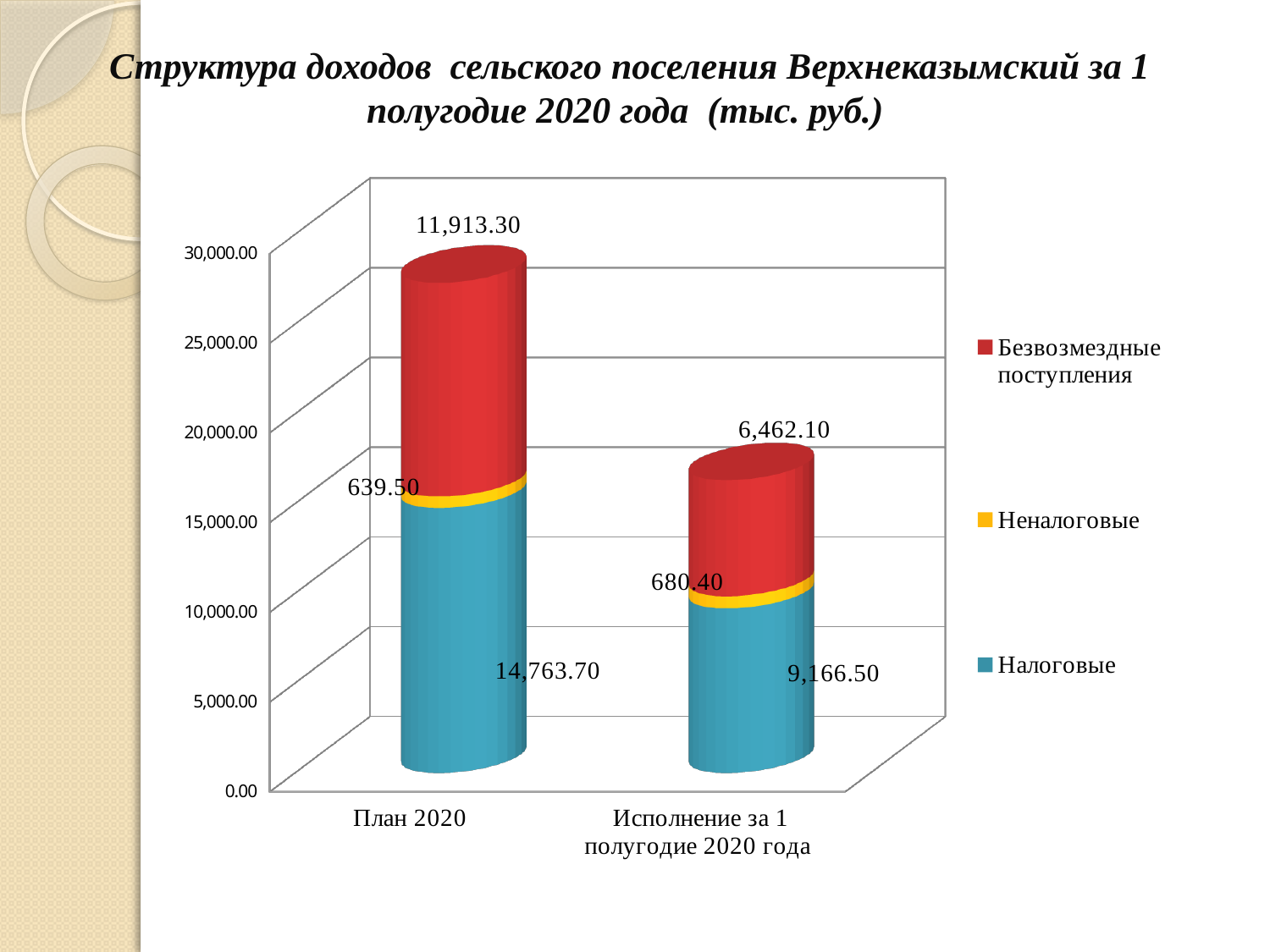
What is the value of Налоговые for План 2020? 14,763.70 Which series is the smallest segment in the Исполнение за 1 полугодие 2020 года bar? Неналоговые What type of chart is shown on the slide? Stacked bar chart How many series does the legend list? 3 What is the total of the stacked bar for План 2020? 27,316.50 Which colour represents Налоговые in the chart? Blue What is the value of Безвозмездные поступления for Исполнение за 1 полугодие 2020 года? 6,462.10 What is the total of the stacked bar for Исполнение за 1 полугодие 2020 года? 16,309.00 What is the value of Неналоговые for План 2020? 639.50 What is the difference between the Налоговые values for План 2020 and Исполнение за 1 полугодие 2020 года? 5,597.20 How many categories are shown on the x axis? 2 Which category has the higher Безвозмездные поступления value, План 2020 or Исполнение за 1 полугодие 2020 года? План 2020